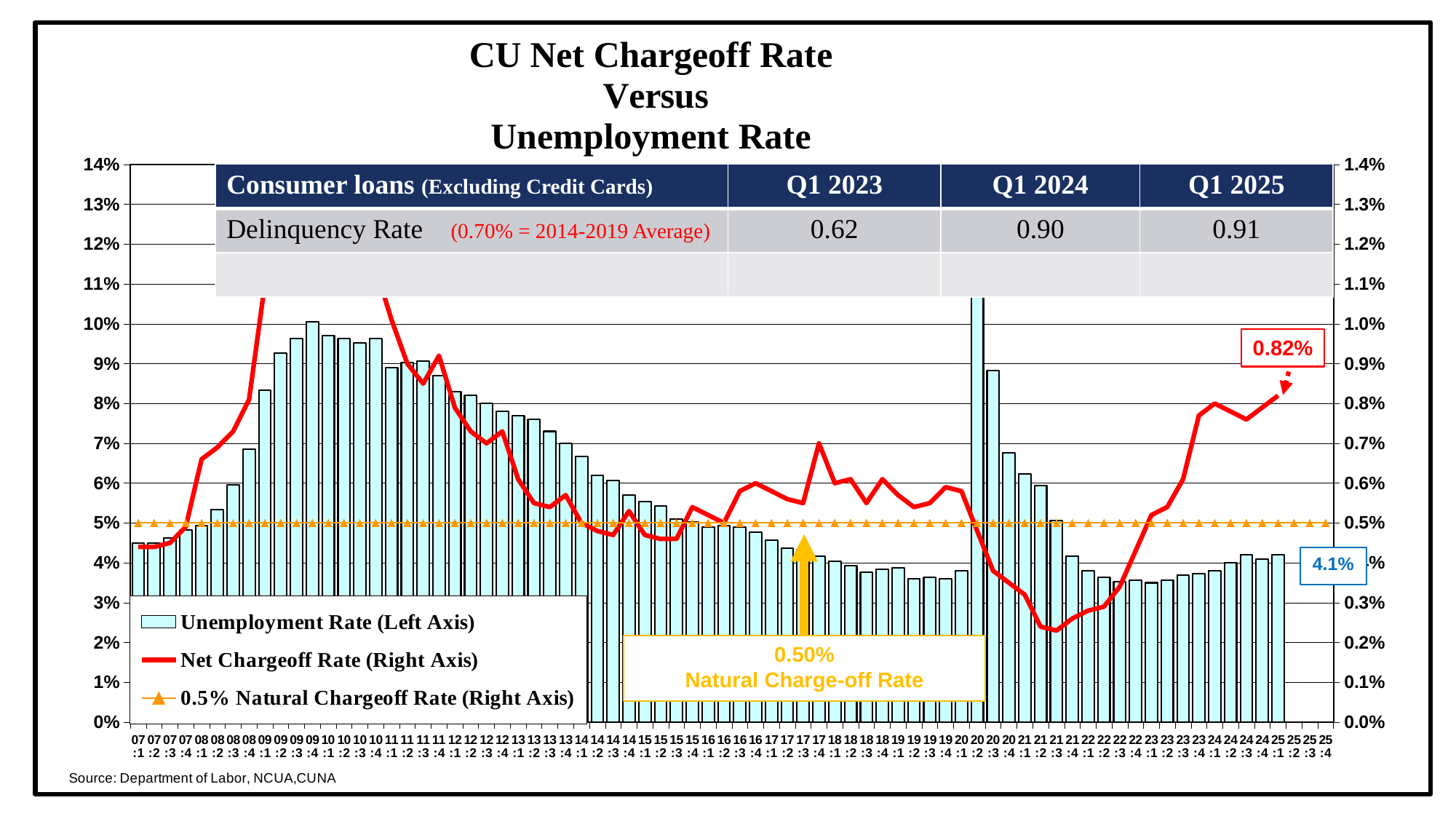
What is the latest labeled value of the Unemployment Rate? 4.1% Which quarter has the highest Unemployment Rate bar? 20:2 How many series does the chart legend list? 3 What kind of chart is this? Combination bar and line chart In the table, what is the Delinquency Rate for consumer loans in Q1 2024? 0.90 In the table, which is larger, the Delinquency Rate for Q1 2023 or Q1 2025? Q1 2025 Is the Net Chargeoff Rate for 21:3 greater or less than 0.3%? less What is the latest labeled value of the Net Chargeoff Rate (25:1)? 0.82% In the table, what is the difference between the Delinquency Rate in Q1 2024 and Q1 2023? 0.28 What value is the Natural Charge-off Rate line set at? 0.50% Is the Unemployment Rate for 20:2 greater or less than 10%? greater What is the title of the chart? CU Net Chargeoff Rate Versus Unemployment Rate